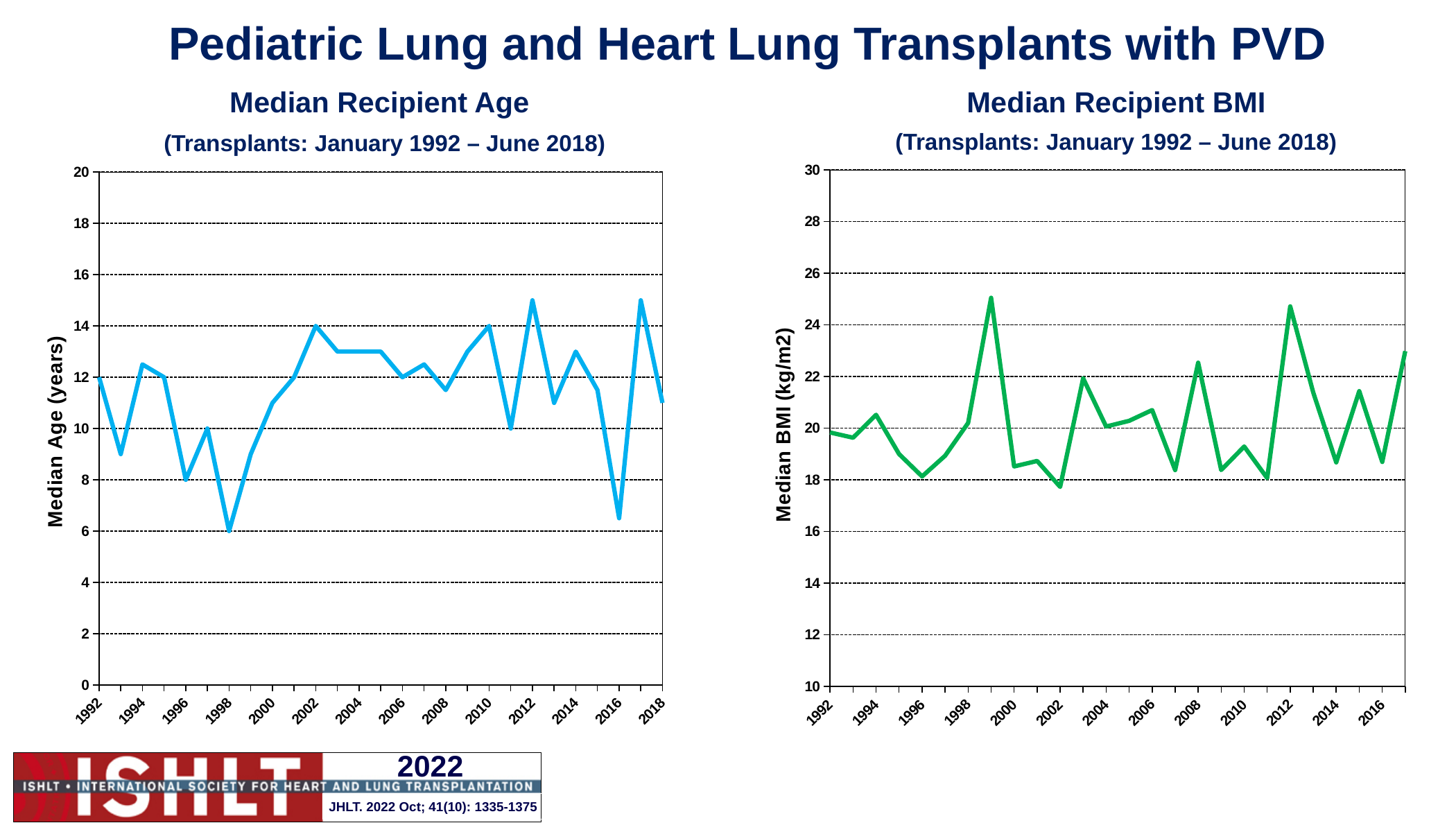
What colour is the line in the Median Recipient Age chart? blue In the Median Recipient BMI chart, is the value for 1996 greater or less than 20? less In the Median Recipient Age chart, is the value for 2016 greater or less than 8? less What is the y-axis label of the Median Recipient BMI chart? Median BMI (kg/m2) What kind of chart is the Median Recipient BMI chart on the right? line chart In the Median Recipient BMI chart, is the value for 2002 greater or less than 18? less What kind of chart is the Median Recipient Age chart on the left? line chart